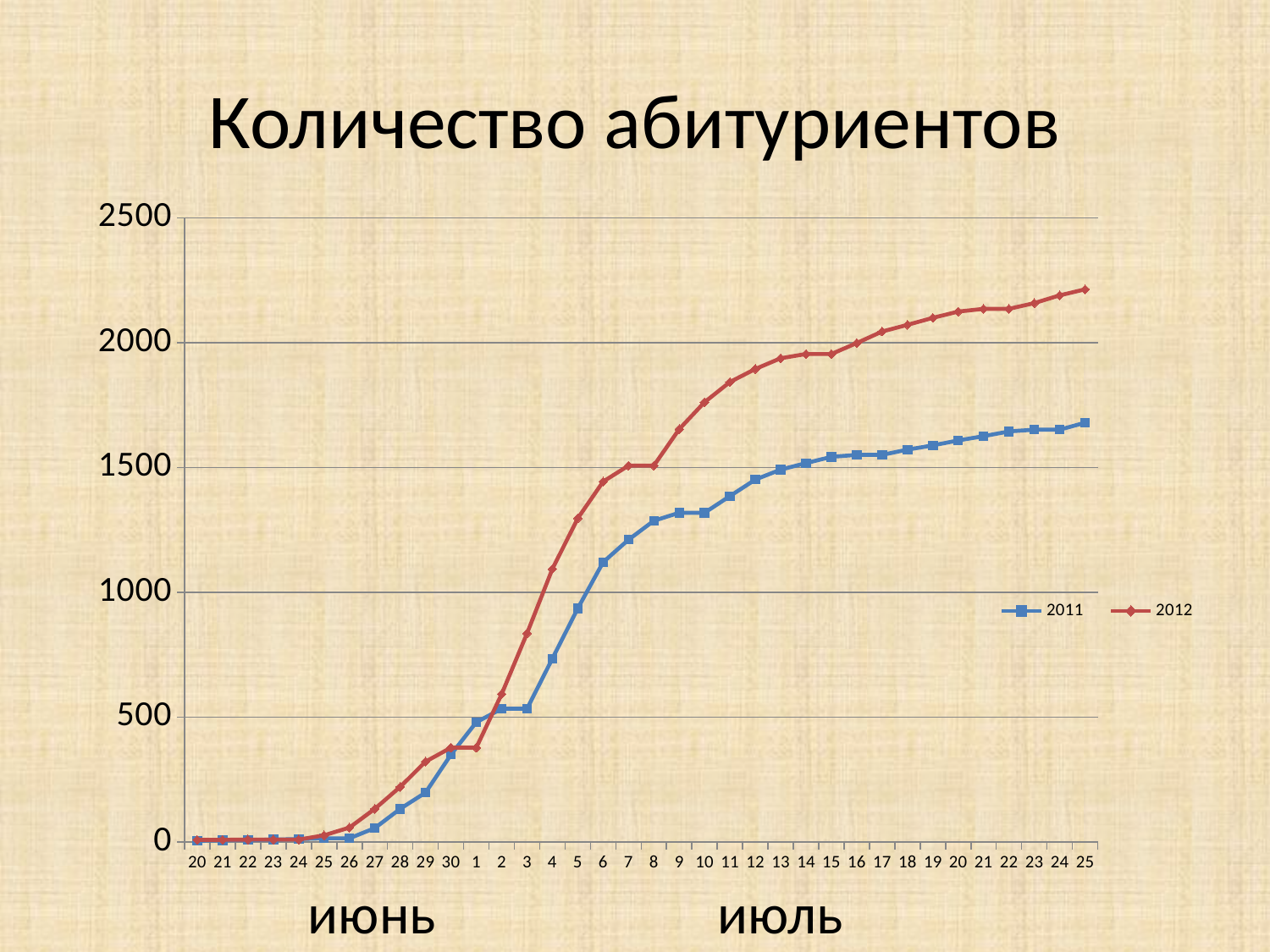
Is the value for 2012 on 10 июль greater or less than 1500? greater Do the values for the 2012 series rise or fall along the x axis? rise What are the two series named in the legend? 2011 and 2012 Is the value for 2012 on 25 июль greater or less than 2000? greater Is the value for 2011 on 25 июль greater or less than 2000? less What is the title of the chart? Количество абитуриентов What kind of chart is shown on the slide? line chart How many series does the legend list? 2 How many dates are plotted along the x axis? 36 On 1 июль, which series has the higher value, 2011 or 2012? 2011 On 25 июль, which series has the higher value, 2011 or 2012? 2012